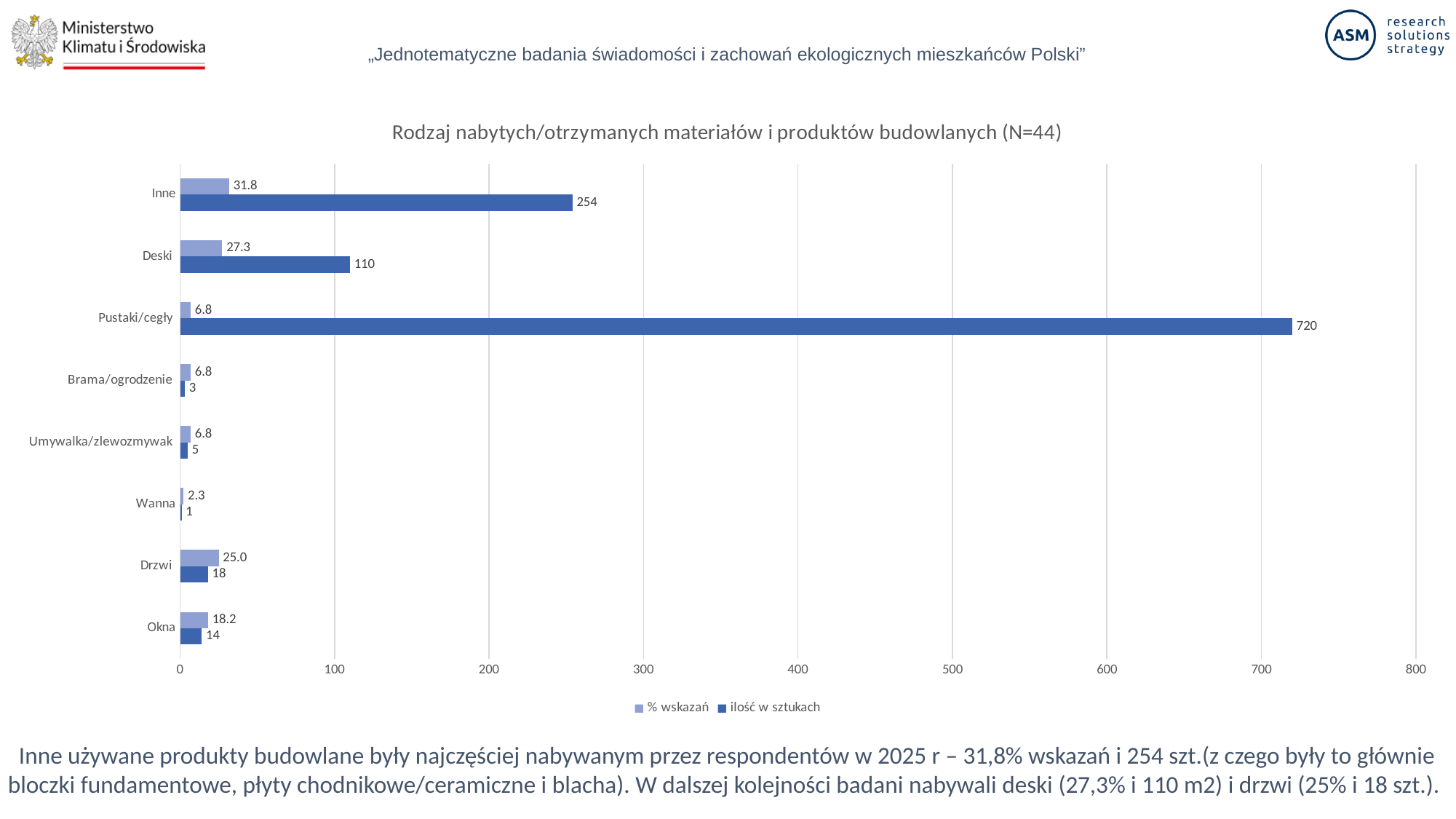
What kind of chart is shown on the slide? bar chart Which has a larger "% wskazań" value, Drzwi or Okna? Drzwi Which category has the highest "ilość w sztukach" value? Pustaki/cegły What is the "ilość w sztukach" value for Deski? 110 What is the "ilość w sztukach" value for Pustaki/cegły? 720 What is the difference between the "ilość w sztukach" values for Inne and Deski? 144 Which category has the lowest "% wskazań" value? Wanna What is the "% wskazań" value for Inne? 31.8 How many categories are shown on the chart? 8 How many series does the legend list? 2 What is the title of the chart? Rodzaj nabytych/otrzymanych materiałów i produktów budowlanych (N=44) Is the "ilość w sztukach" value for Pustaki/cegły greater or less than 700? greater